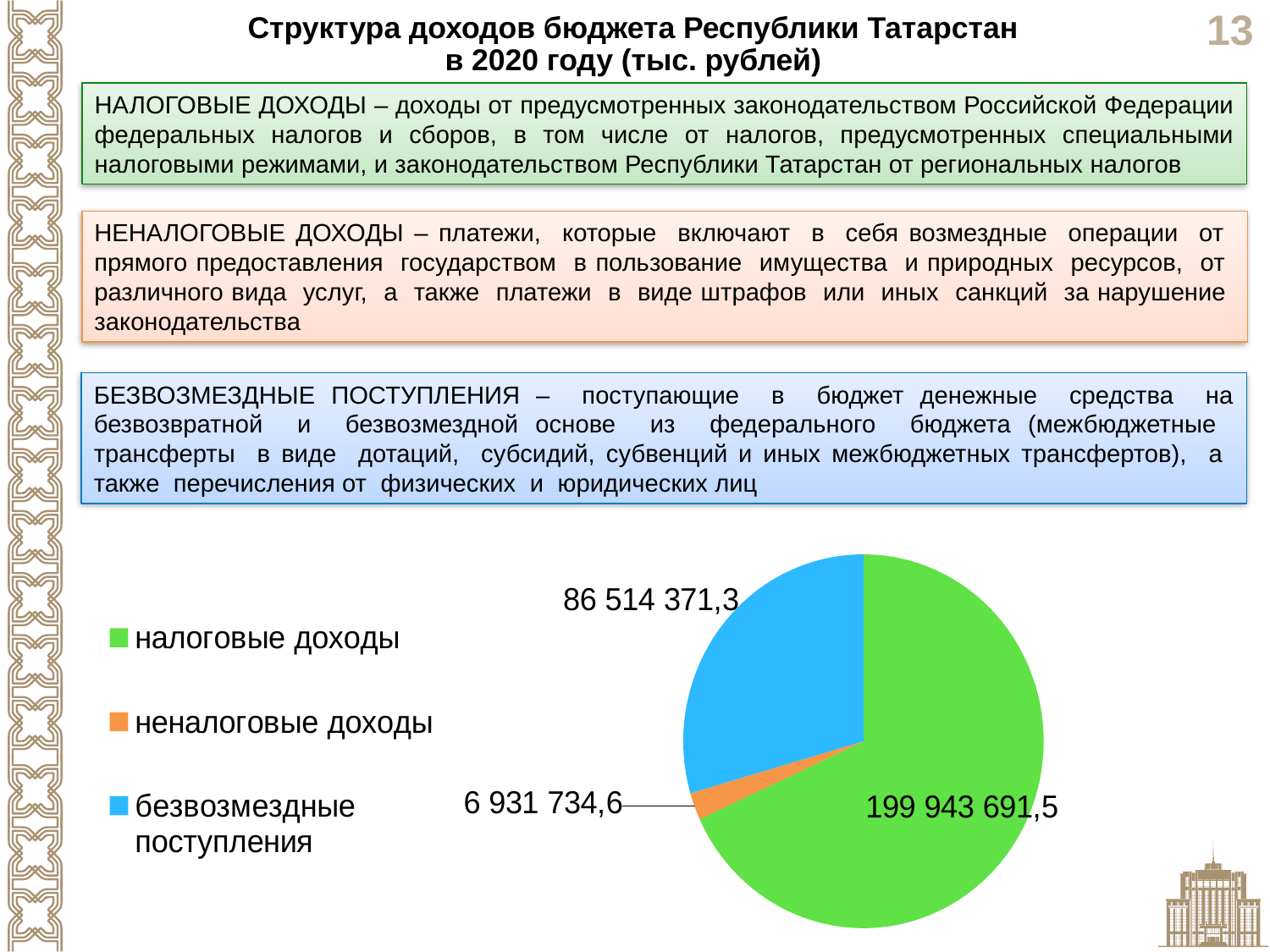
What is the value for налоговые доходы in the pie chart? 199 943 691,5 Which category has the smallest slice in the pie chart? неналоговые доходы How many categories does the pie chart show? 3 What is the value for безвозмездные поступления in the pie chart? 86 514 371,3 What colour is the slice for безвозмездные поступления? blue Which category has the largest slice in the pie chart? налоговые доходы What kind of chart is shown on the slide? pie chart What is the value for неналоговые доходы in the pie chart? 6 931 734,6 What is the total of all three slices in the pie chart? 293 389 797,4 Which is larger: безвозмездные поступления or неналоговые доходы? безвозмездные поступления What is the difference between безвозмездные поступления and неналоговые доходы? 79 582 636,7 What is the difference between налоговые доходы and безвозмездные поступления? 113 429 320,2